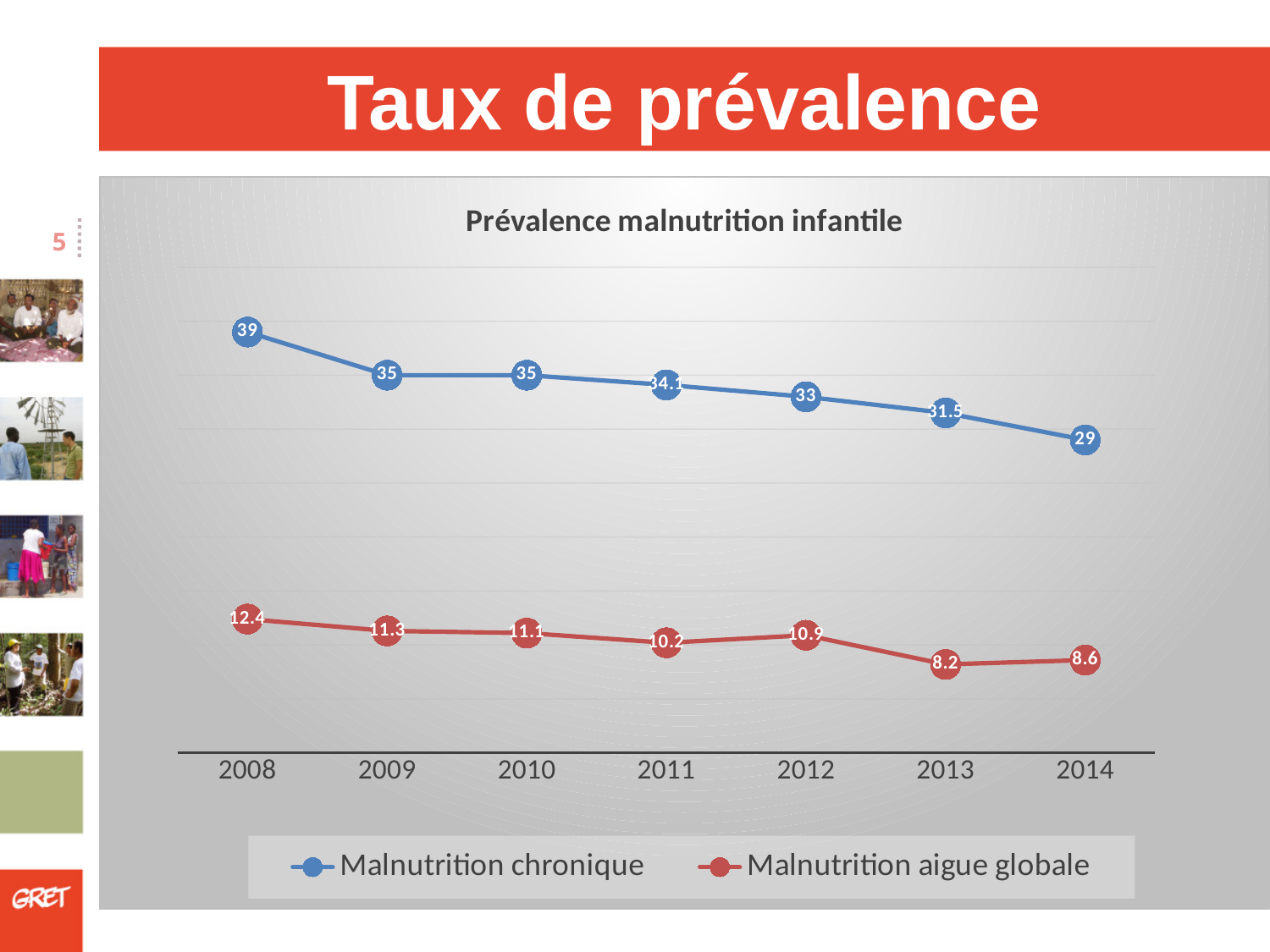
How many series does the legend list? 2 In which year is Malnutrition chronique highest? 2008 In which year is Malnutrition aigue globale lowest? 2013 What is the value for Malnutrition aigue globale in 2012? 10.9 What is the value for Malnutrition chronique in 2014? 29 What is the value for Malnutrition chronique in 2008? 39 Does Malnutrition chronique rise or fall from 2008 to 2014? Fall What kind of chart is shown? Line chart What is the difference between Malnutrition chronique in 2008 and in 2014? 10 Which is larger: Malnutrition aigue globale in 2012 or in 2013? 2012 How many years are shown on the x axis? 7 What is the value for Malnutrition aigue globale in 2013? 8.2